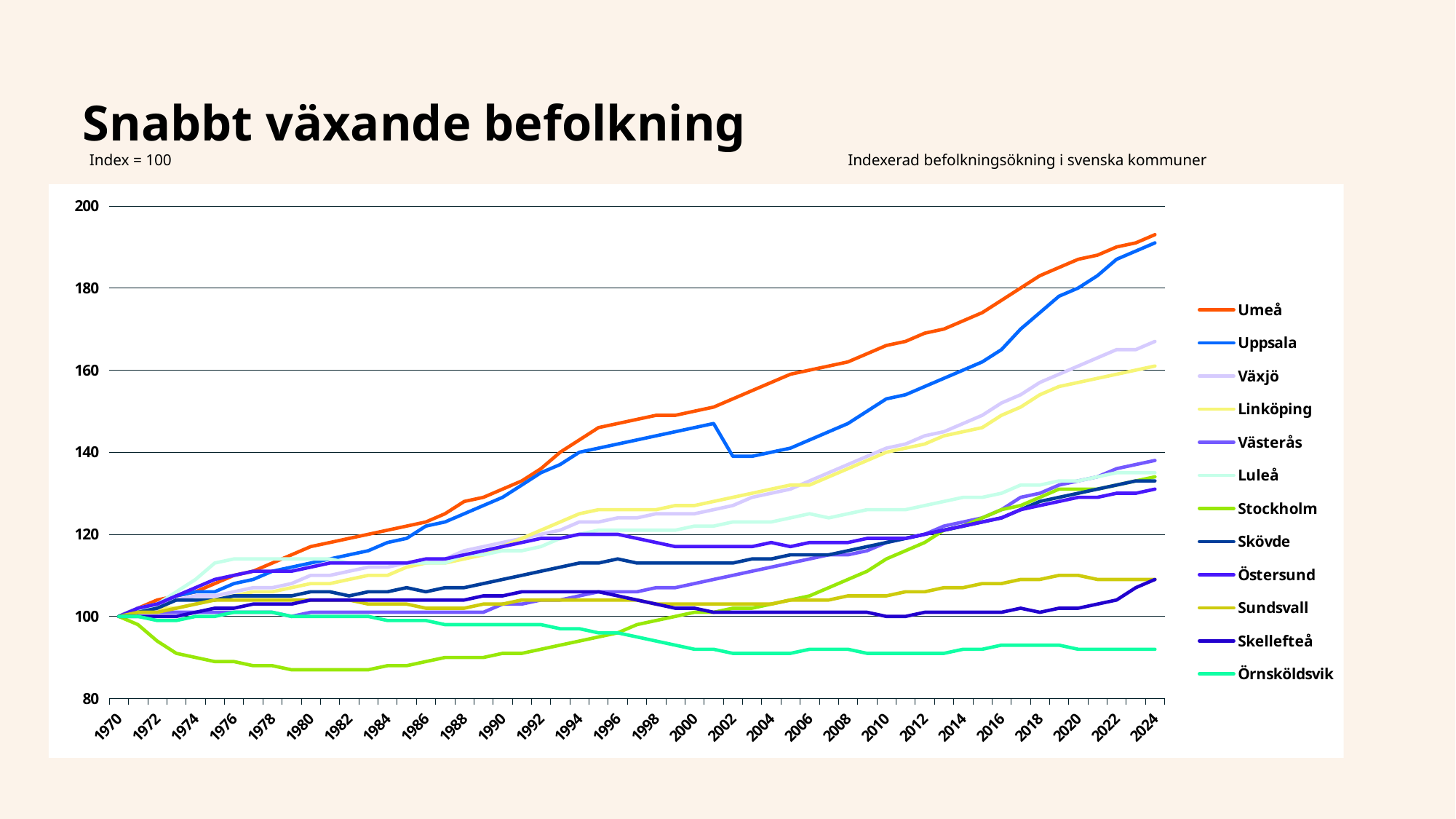
What is the title of the slide? Snabbt växande befolkning Which municipality has the lowest index value in 2024? Örnsköldsvik Is the value for Stockholm in 1980 greater or less than 100? less Which municipality has the highest index value in 2024? Umeå What kind of chart is shown on the slide? line chart Which has the higher index value in 2024, Stockholm or Örnsköldsvik? Stockholm Is the value for Umeå in 2024 greater or less than 180? greater Is the value for Örnsköldsvik in 2024 greater or less than 100? less Does the index for Umeå rise or fall from 1970 to 2024? rise How many municipalities (series) does the legend list? 12 What is the index value for all municipalities in the starting year 1970? 100